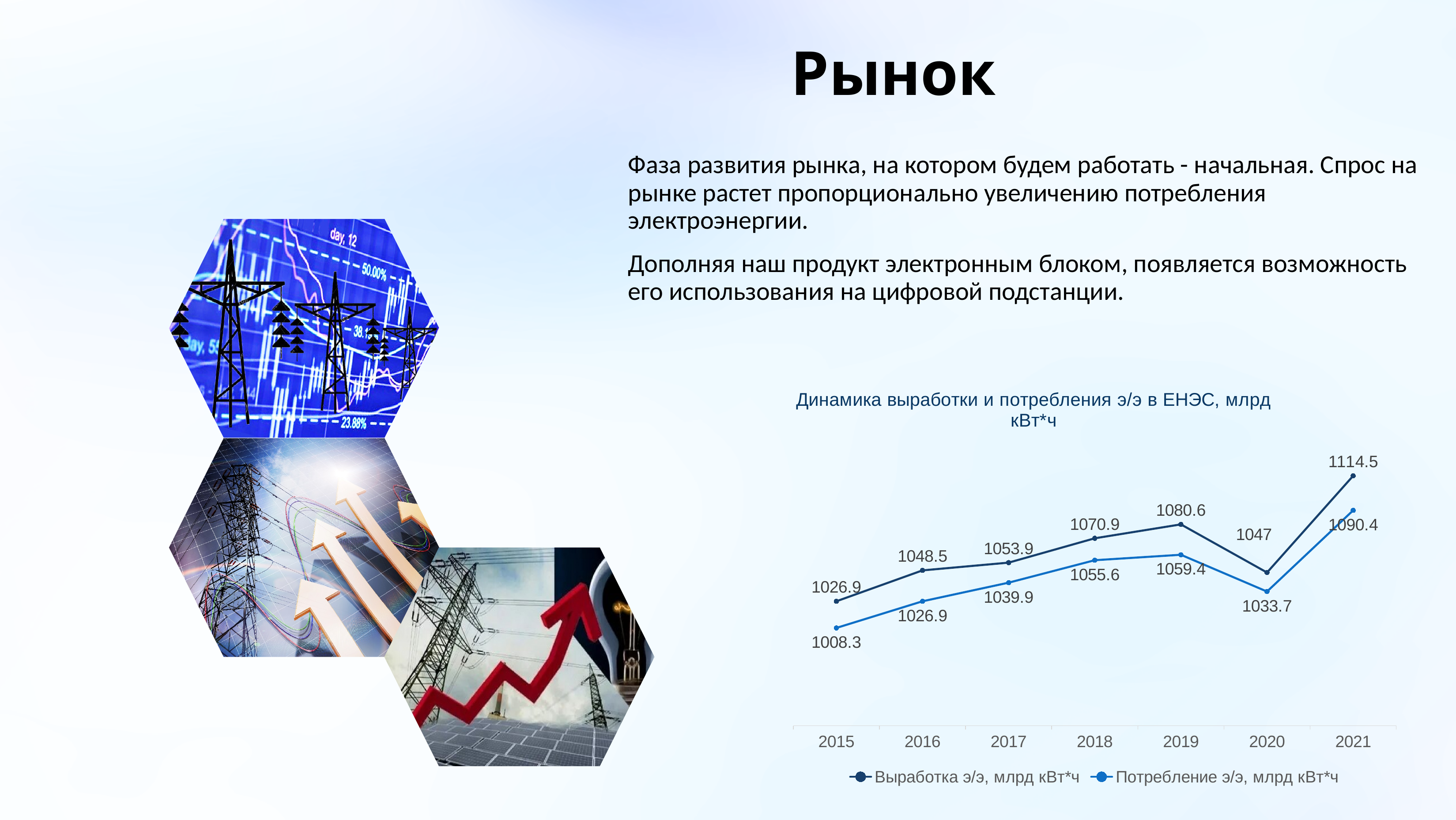
What is the title of the chart? Динамика выработки и потребления э/э в ЕНЭС, млрд кВт*ч In which year is Выработка э/э highest? 2021 What type of chart is shown on the slide? line chart What is the value of Потребление э/э in 2018? 1055.6 In which year is Потребление э/э lowest? 2015 How many years are shown on the x axis of the chart? 7 What is the value of Потребление э/э in 2015? 1008.3 How many series does the chart legend list? 2 Which is larger in 2017: Выработка э/э or Потребление э/э? Выработка э/э What is the value of Выработка э/э in 2020? 1047 What is the difference between Выработка э/э and Потребление э/э in 2019? 21.2 What is the value of Выработка э/э in 2021? 1114.5